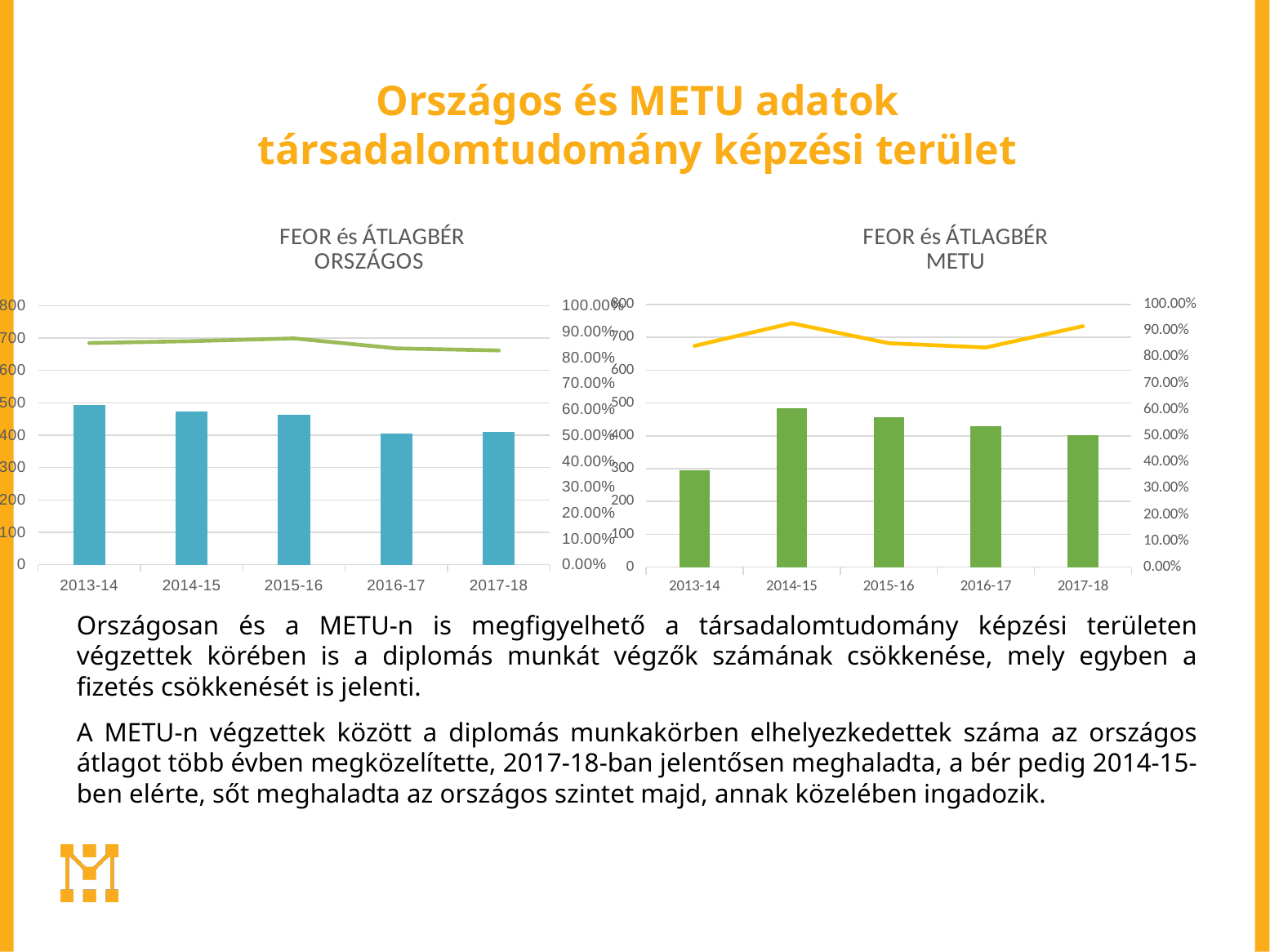
In the 'FEOR és ÁTLAGBÉR ORSZÁGOS' chart, what kind of chart is used for the yearly values? A bar chart combined with a line In the 'FEOR és ÁTLAGBÉR METU' chart, which year has the higher line value, 2014-15 or 2016-17? 2014-15 In the 'FEOR és ÁTLAGBÉR ORSZÁGOS' chart, which year has the tallest bar? 2013-14 In the 'FEOR és ÁTLAGBÉR ORSZÁGOS' chart, is the bar for 2013-14 greater or less than 400? greater In the 'FEOR és ÁTLAGBÉR ORSZÁGOS' chart, do the bar values generally rise or fall from 2013-14 to 2017-18? fall In the 'FEOR és ÁTLAGBÉR METU' chart, which year has the tallest bar? 2014-15 What is the title of the chart on the right side of the slide? FEOR és ÁTLAGBÉR METU In the 'FEOR és ÁTLAGBÉR METU' chart, which year has the shortest bar? 2013-14 In the 'FEOR és ÁTLAGBÉR ORSZÁGOS' chart, how many academic years are shown on the x axis? 5 In the 'FEOR és ÁTLAGBÉR ORSZÁGOS' chart, is the bar for 2016-17 greater or less than 500? less